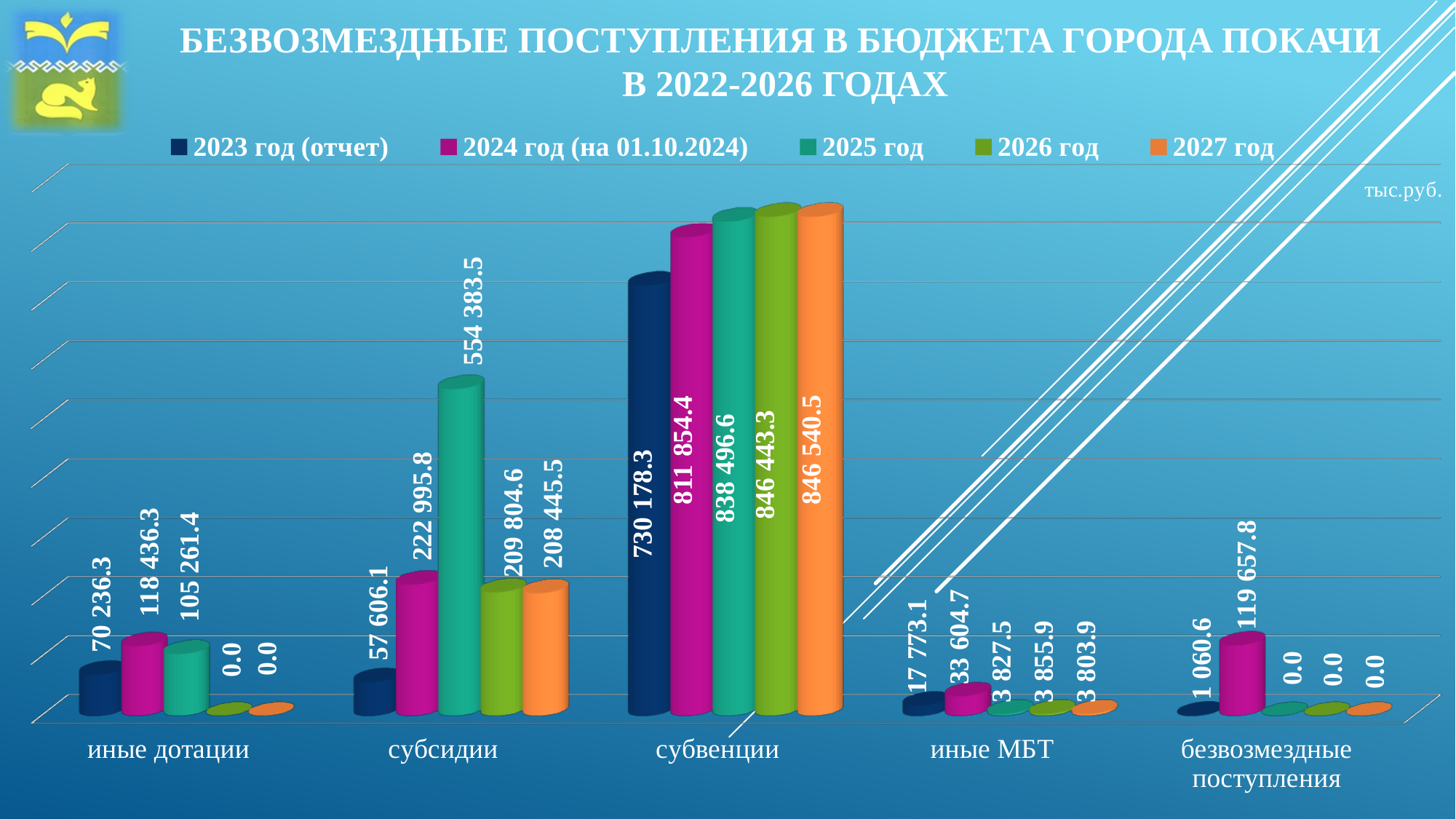
How many series does the legend list? 5 What is the value for иные МБТ in 2023 год (отчет)? 17 773.1 What is the value for субсидии in 2024 год (на 01.10.2024)? 222 995.8 Do the values for субвенции rise or fall from 2023 год to 2027 год? rise Which is larger for иные дотации: the 2024 год value or the 2025 год value? 2024 год (на 01.10.2024) What kind of chart is shown on the slide? bar chart How many categories are shown on the x axis? 5 What is the difference between the 2025 год and 2024 год values for субсидии? 331 387.7 Which year has the lowest value for субсидии? 2023 год (отчет) What is the value for субвенции in 2025 год? 838 496.6 Which category has the highest value in 2023 год (отчет)? субвенции What is the value for безвозмездные поступления in 2027 год? 0.0